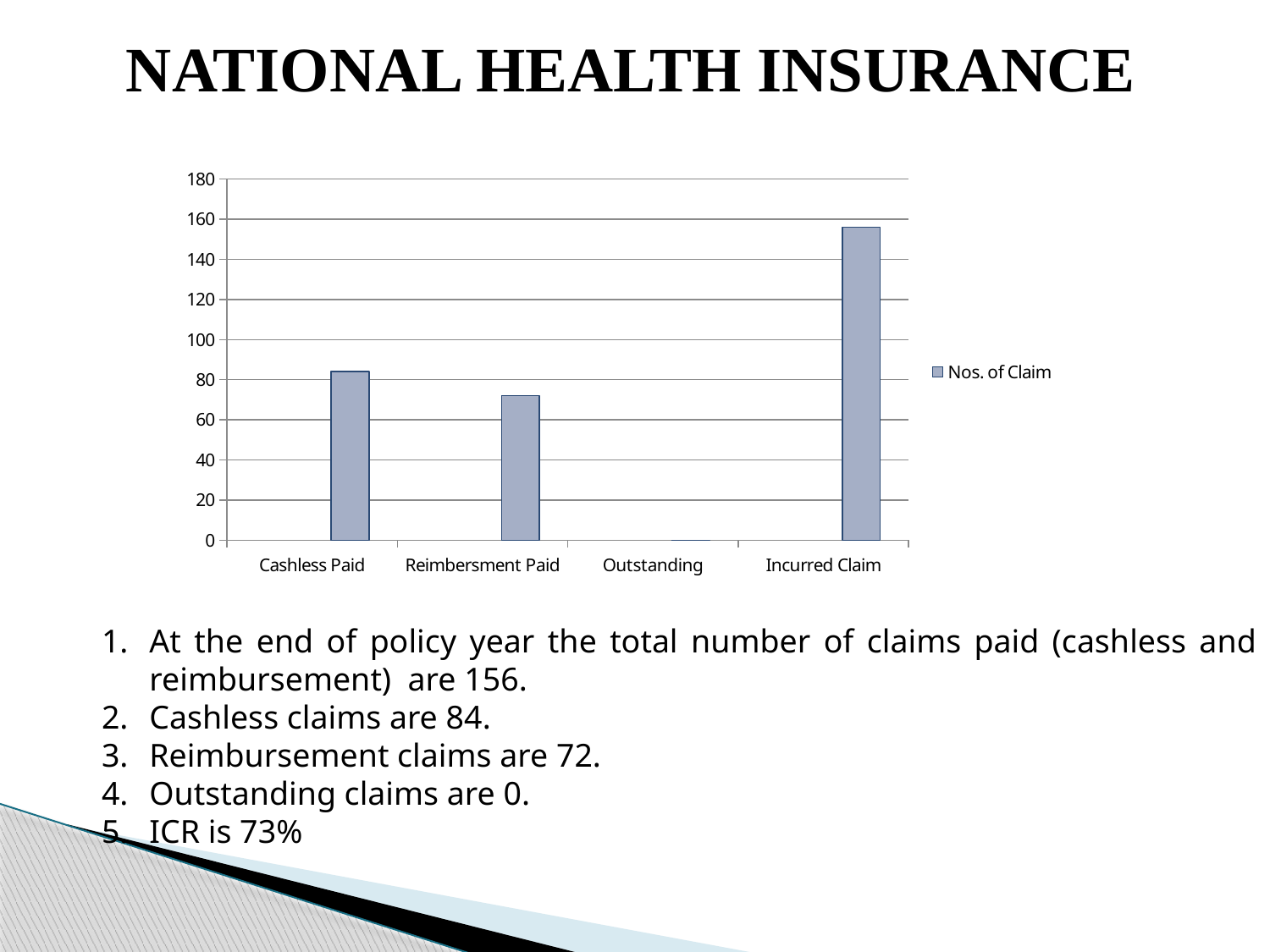
Is the value for Reimbursment Paid greater or less than 80? less What is the value for Outstanding in the chart? 0 Which category has the lowest number of claims? Outstanding Which category has the highest number of claims? Incurred Claim How many categories are shown on the x axis of the chart? 4 What is the name of the series in the chart legend? Nos. of Claim Is the value for Incurred Claim greater or less than 140? greater What is the value for Cashless Paid in the chart? 84 Which is larger, the value for Cashless Paid or the value for Reimbursment Paid? Cashless Paid What kind of chart is shown on the slide? bar chart How many series does the chart legend list? 1 What is the value for Reimbursment Paid in the chart? 72